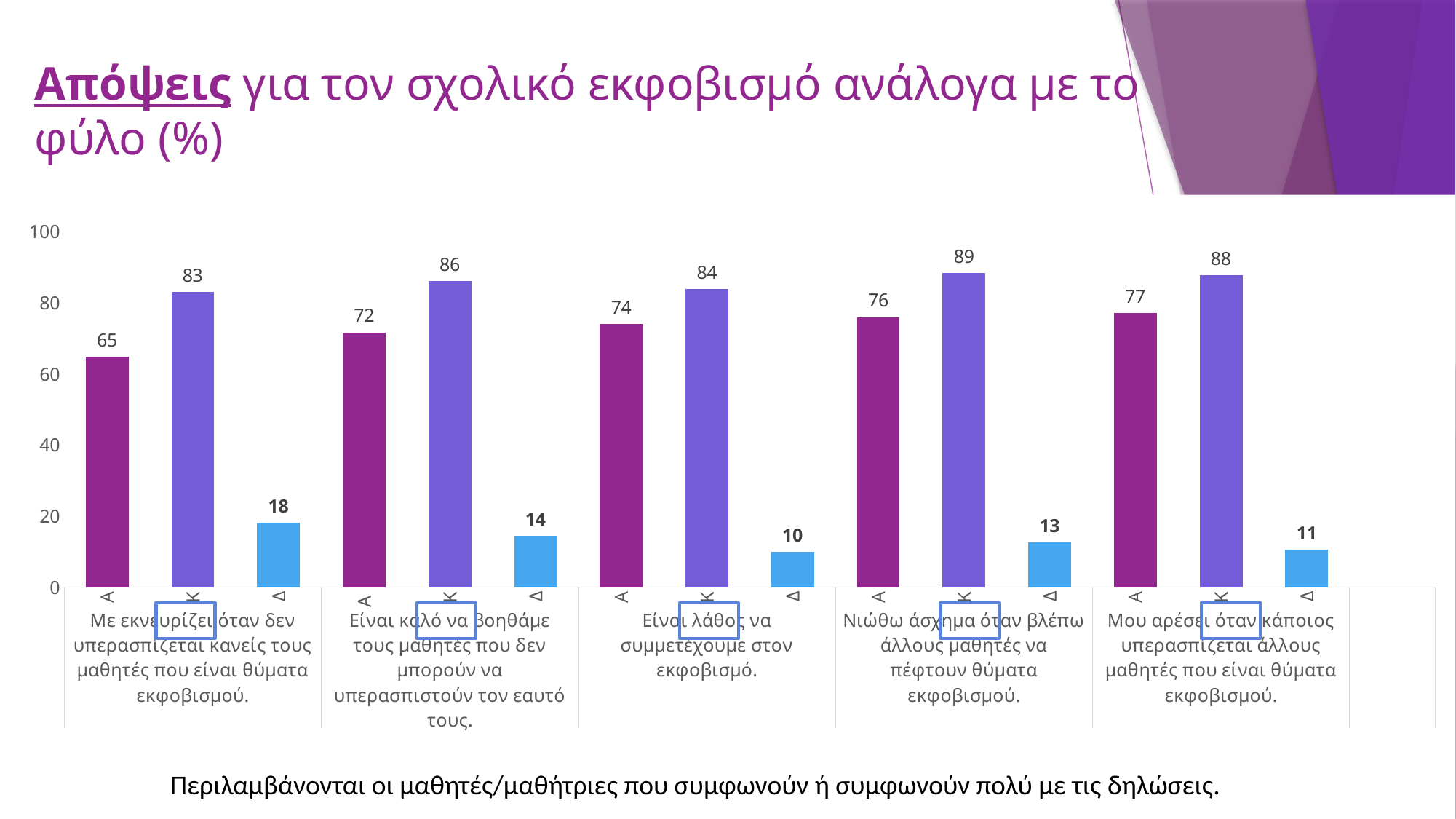
What kind of chart is shown on the slide? bar chart What is the title of the slide? Απόψεις για τον σχολικό εκφοβισμό ανάλογα με το φύλο (%) Which statement has the highest Κ value? Νιώθω άσχημα όταν βλέπω άλλους μαθητές να πέφτουν θύματα εκφοβισμού. What is the difference between the Κ and Α values for the statement "Μου αρέσει όταν κάποιος υπερασπίζεται άλλους μαθητές που είναι θύματα εκφοβισμού."? 11 Which statement has the lowest Δ value? Είναι λάθος να συμμετέχουμε στον εκφοβισμό. How many statements (category groups) are shown on the x axis? 5 Is the Δ value for "Με εκνευρίζει όταν δεν υπερασπίζεται κανείς τους μαθητές που είναι θύματα εκφοβισμού." greater or less than 20? less What is the value of the Α bar for the statement "Με εκνευρίζει όταν δεν υπερασπίζεται κανείς τους μαθητές που είναι θύματα εκφοβισμού."? 65 What is the value of the Κ bar for the statement "Είναι λάθος να συμμετέχουμε στον εκφοβισμό."? 84 Which statement has the lowest Α value? Με εκνευρίζει όταν δεν υπερασπίζεται κανείς τους μαθητές που είναι θύματα εκφοβισμού. Which is larger: the Α value for "Νιώθω άσχημα όταν βλέπω άλλους μαθητές να πέφτουν θύματα εκφοβισμού." or the Α value for "Είναι καλό να βοηθάμε τους μαθητές που δεν μπορούν να υπερασπιστούν τον εαυτό τους."? Νιώθω άσχημα όταν βλέπω άλλους μαθητές να πέφτουν θύματα εκφοβισμού. What is the value of the Δ bar for the statement "Είναι καλό να βοηθάμε τους μαθητές που δεν μπορούν να υπερασπιστούν τον εαυτό τους."? 14